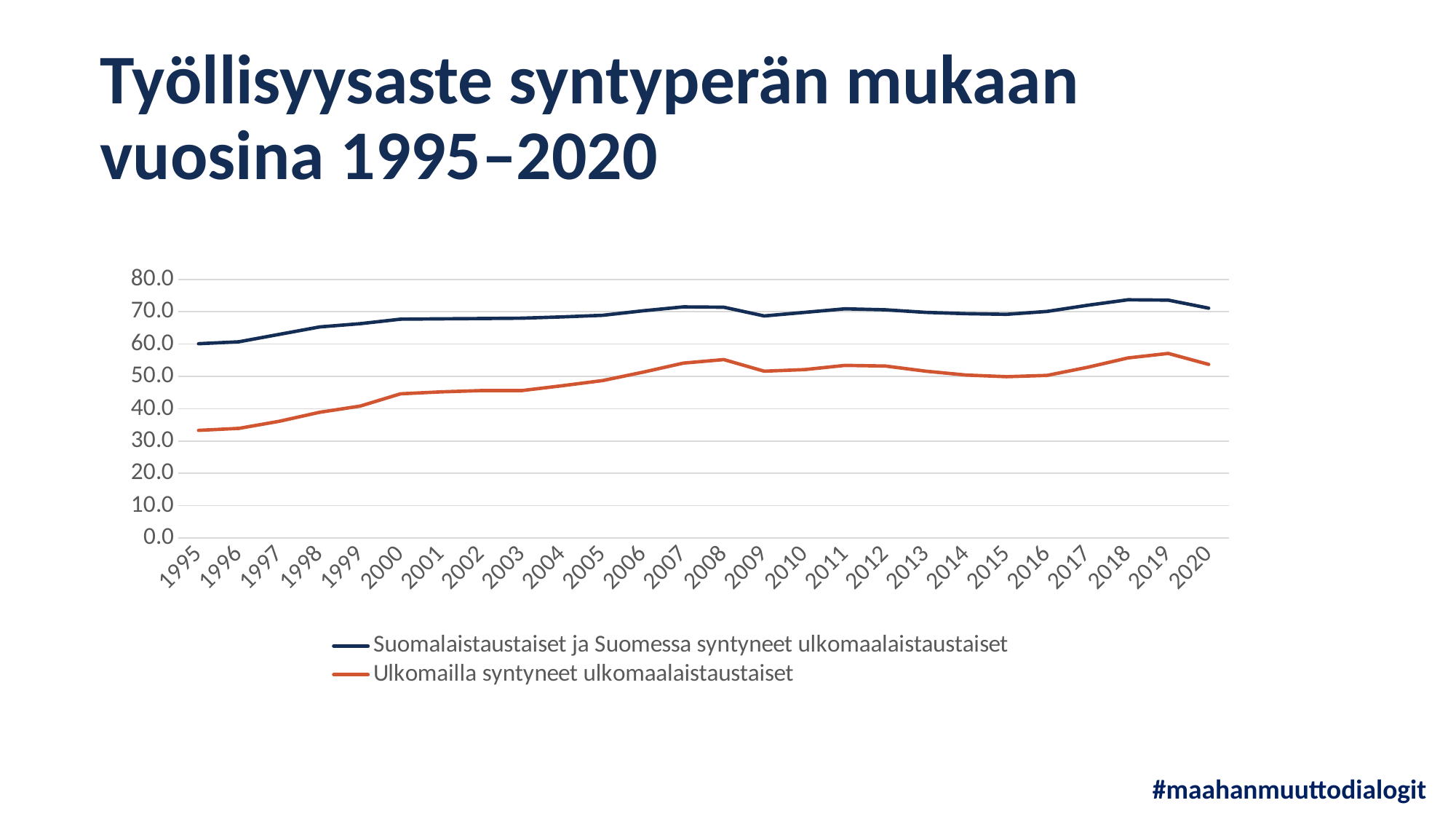
In which year is the value for Ulkomailla syntyneet ulkomaalaistaustaiset lowest? 1995 How many series does the legend list? 2 Is the value for Ulkomailla syntyneet ulkomaalaistaustaiset in 2020 greater or less than 60.0? less Is the value for Suomalaistaustaiset ja Suomessa syntyneet ulkomaalaistaustaiset in 2018 greater or less than 70.0? greater Is the value for Ulkomailla syntyneet ulkomaalaistaustaiset in 2008 greater or less than 50.0? greater Does the value for Ulkomailla syntyneet ulkomaalaistaustaiset rise or fall from 1995 to 2008? rise What is the title of the chart slide? Työllisyysaste syntyperän mukaan vuosina 1995–2020 What kind of chart is shown on the slide? line chart In 2010, which series has the higher value: Suomalaistaustaiset ja Suomessa syntyneet ulkomaalaistaustaiset or Ulkomailla syntyneet ulkomaalaistaustaiset? Suomalaistaustaiset ja Suomessa syntyneet ulkomaalaistaustaiset How many years are shown along the x axis? 26